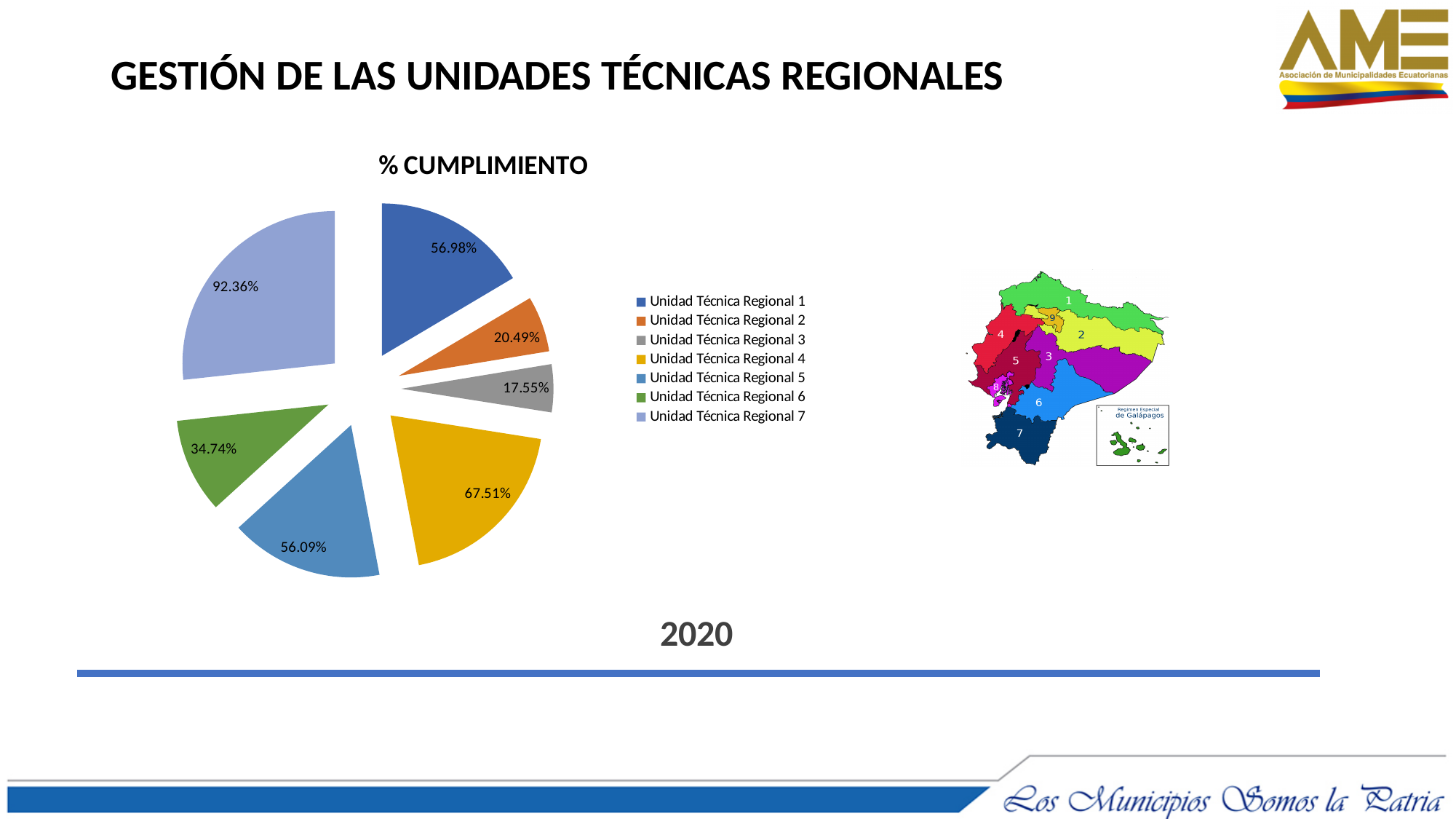
What is the value shown for Unidad Técnica Regional 7? 92.36% What is the value shown for Unidad Técnica Regional 1? 56.98% Which Unidad Técnica Regional has the lowest value in the pie chart? Unidad Técnica Regional 3 What is the value shown for Unidad Técnica Regional 3? 17.55% Which Unidad Técnica Regional has the highest value in the pie chart? Unidad Técnica Regional 7 What is the value shown for Unidad Técnica Regional 4? 67.51% What is the difference between the values for Unidad Técnica Regional 7 and Unidad Técnica Regional 4? 24.85% What is the difference between the values for Unidad Técnica Regional 2 and Unidad Técnica Regional 3? 2.94% What is the title of the pie chart? % CUMPLIMIENTO How many slices does the pie chart have? 7 What type of chart is shown under the title "% CUMPLIMIENTO"? Pie chart Which has a larger value, Unidad Técnica Regional 6 or Unidad Técnica Regional 2? Unidad Técnica Regional 6